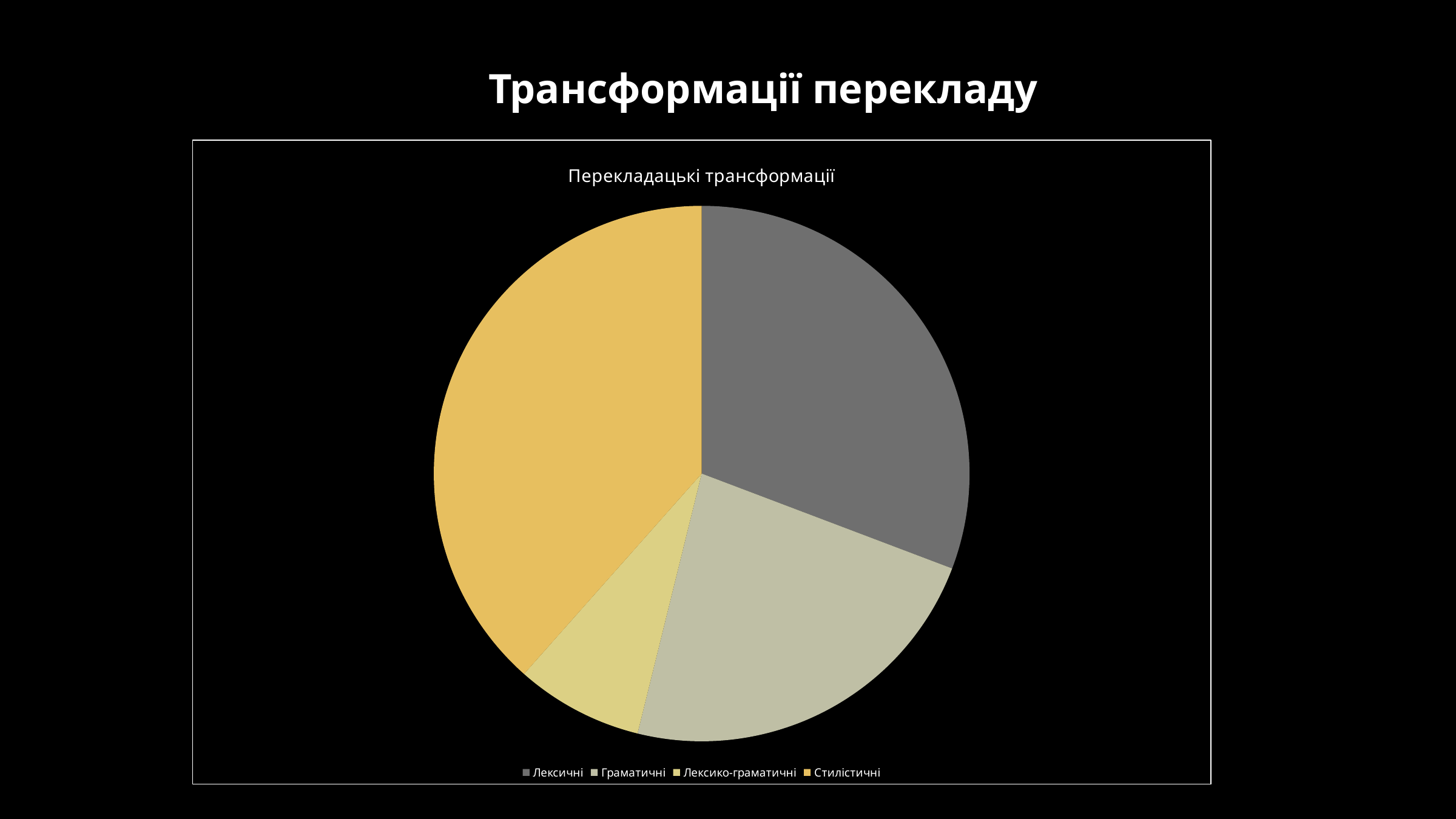
Which slice is larger, Стилістичні or Лексичні? Стилістичні Which category has the smallest slice in the pie chart? Лексико-граматичні How many slices does the pie chart have? 4 Which slice is larger, Граматичні or Лексико-граматичні? Граматичні How many entries does the legend of the pie chart list? 4 Which slice is larger, Лексичні or Граматичні? Лексичні What colour is the Стилістичні slice in the pie chart? Orange-yellow Which category has the largest slice in the pie chart? Стилістичні What kind of chart is shown on the slide? Pie chart What is the title of the pie chart? Перекладацькі трансформації